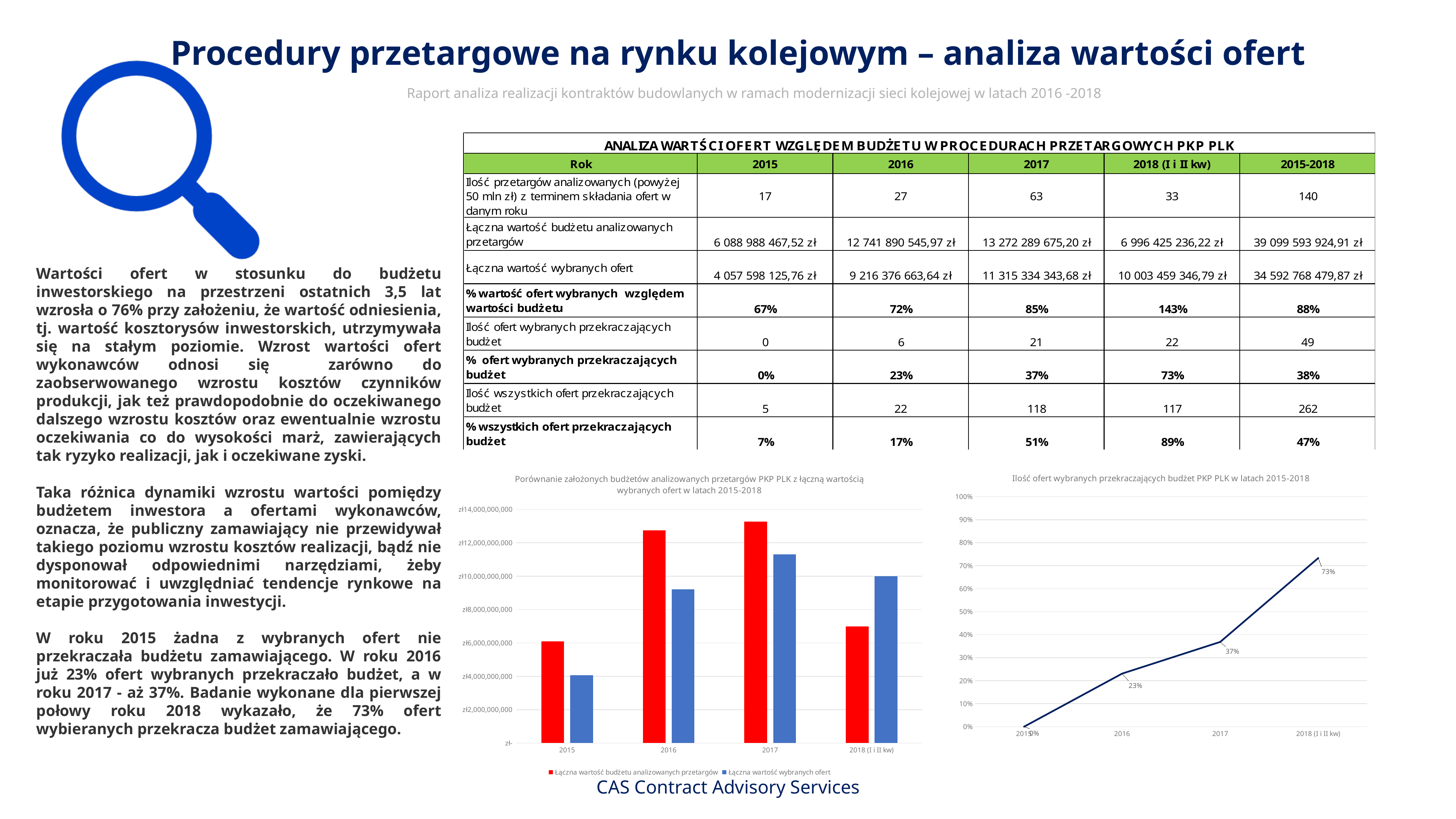
In the line chart on the right, what is the value for 2016? 23% In the line chart on the right, do the values rise or fall from 2015 to 2018 (I i II kw)? rise In the bar chart on the left, is the value of Łączna wartość wybranych ofert for 2016 greater or less than zł10,000,000,000? less In the bar chart on the left, for 2018 (I i II kw), which series has the larger value: Łączna wartość budżetu analizowanych przetargów or Łączna wartość wybranych ofert? Łączna wartość wybranych ofert What kind of chart is the chart on the right? line chart In the line chart on the right, what is the difference between the values for 2017 and 2016? 14% In the line chart on the right, which year has the lowest value? 2015 In the bar chart on the left, is the value of Łączna wartość budżetu analizowanych przetargów for 2017 greater or less than zł12,000,000,000? greater In the line chart on the right, what is the value for 2018 (I i II kw)? 73% In the line chart on the right, how many data points are plotted? 4 In the bar chart on the left, how many series does the legend list? 2 In the bar chart on the left, which year has the highest value of Łączna wartość wybranych ofert? 2017